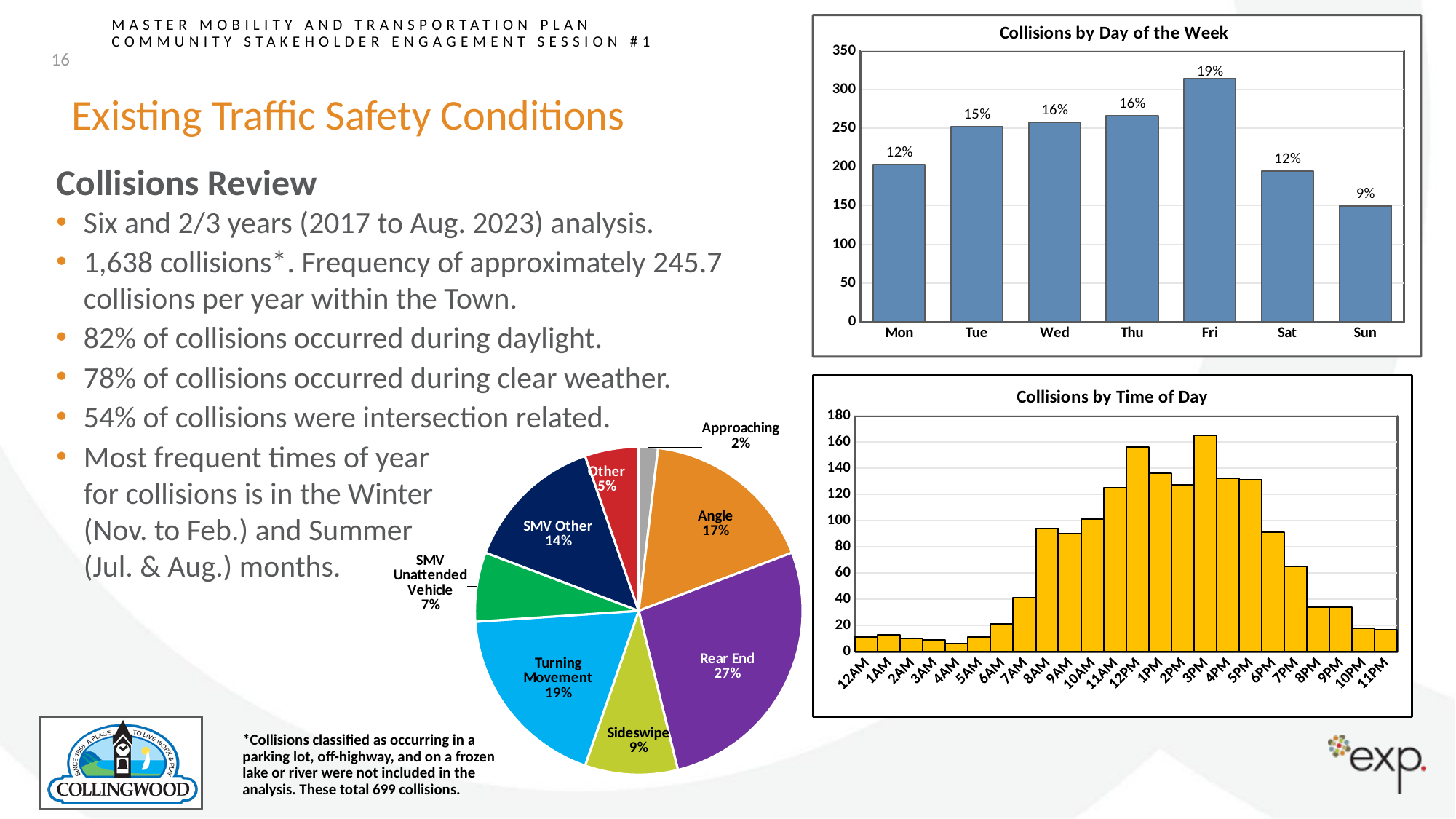
In the pie chart of collision types, what share is Rear End? 27% What kind of chart is 'Collisions by Time of Day'? bar chart In the 'Collisions by Day of the Week' chart, which day has the lowest number of collisions? Sun How many days are shown in the 'Collisions by Day of the Week' chart? 7 In the 'Collisions by Day of the Week' chart, which day has the highest number of collisions? Fri In the 'Collisions by Time of Day' chart, which is larger, the value for 12PM or the value for 1PM? 12PM In the 'Collisions by Time of Day' chart, which hour has the highest number of collisions? 3PM In the 'Collisions by Day of the Week' chart, is the value for Fri greater or less than 300? greater In the pie chart of collision types, what is the difference in percentage points between Turning Movement and Angle? 2 In the pie chart of collision types, which category has the smallest share? Approaching In the 'Collisions by Time of Day' chart, is the value for 12PM greater or less than 140? greater In the 'Collisions by Day of the Week' chart, what percentage label is shown for Friday? 19%